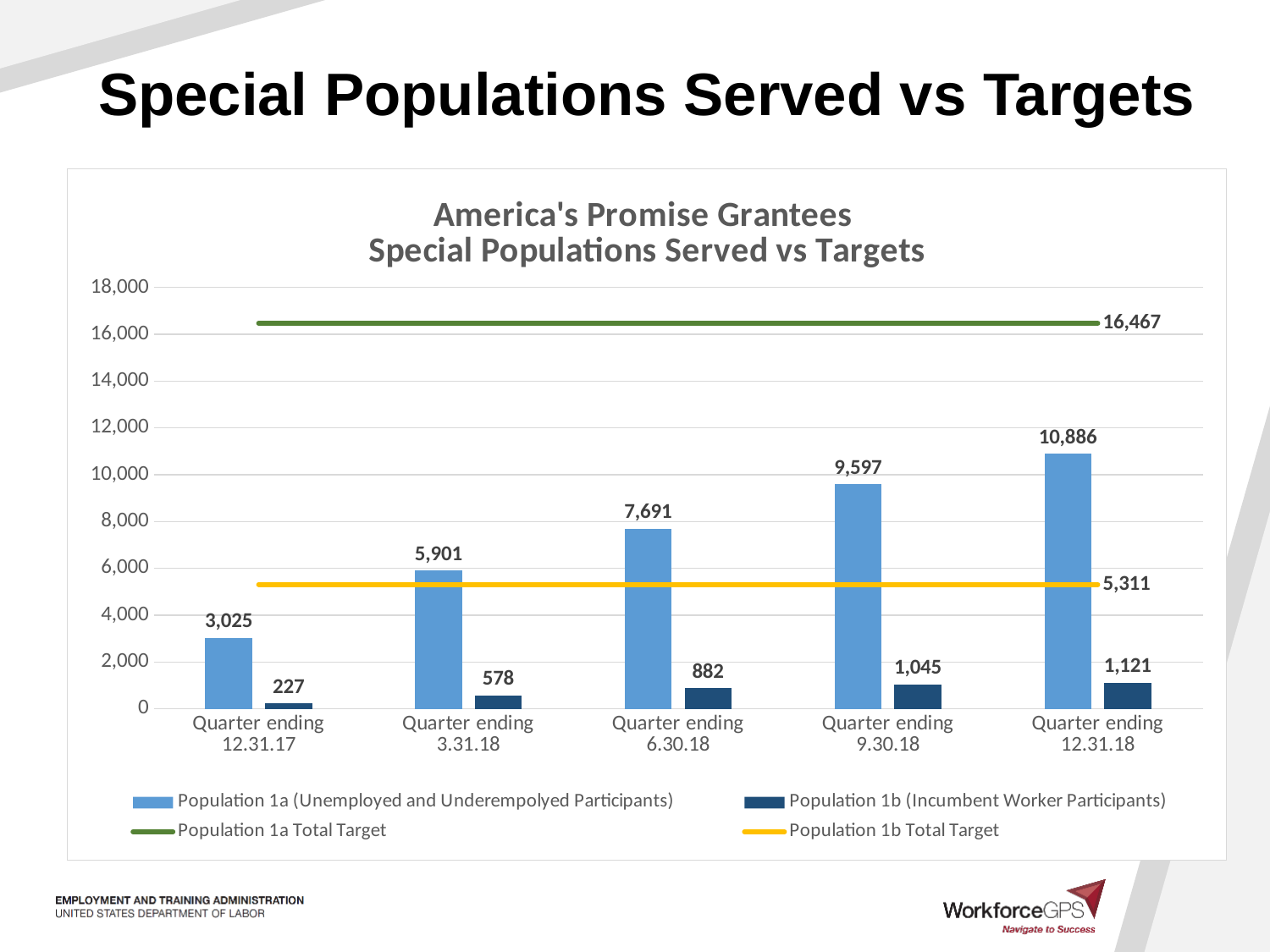
Which is larger: the Population 1b value for the quarter ending 9.30.18 or the quarter ending 6.30.18? Quarter ending 9.30.18 In which quarter is the Population 1b value lowest? Quarter ending 12.31.17 What is the title of the chart? America's Promise Grantees Special Populations Served vs Targets How many quarters are shown on the x axis? 5 How many series does the legend list? 4 In which quarter is the Population 1a value highest? Quarter ending 12.31.18 What is the value for Population 1a (Unemployed and Underemployed Participants) for the quarter ending 6.30.18? 7,691 What is the Population 1a Total Target shown on the chart? 16,467 What is the Population 1b Total Target shown on the chart? 5,311 Do the Population 1a values rise or fall across the quarters from left to right? Rise What is the value for Population 1b (Incumbent Worker Participants) for the quarter ending 12.31.17? 227 What is the difference between the Population 1a values for the quarters ending 12.31.18 and 9.30.18? 1,289